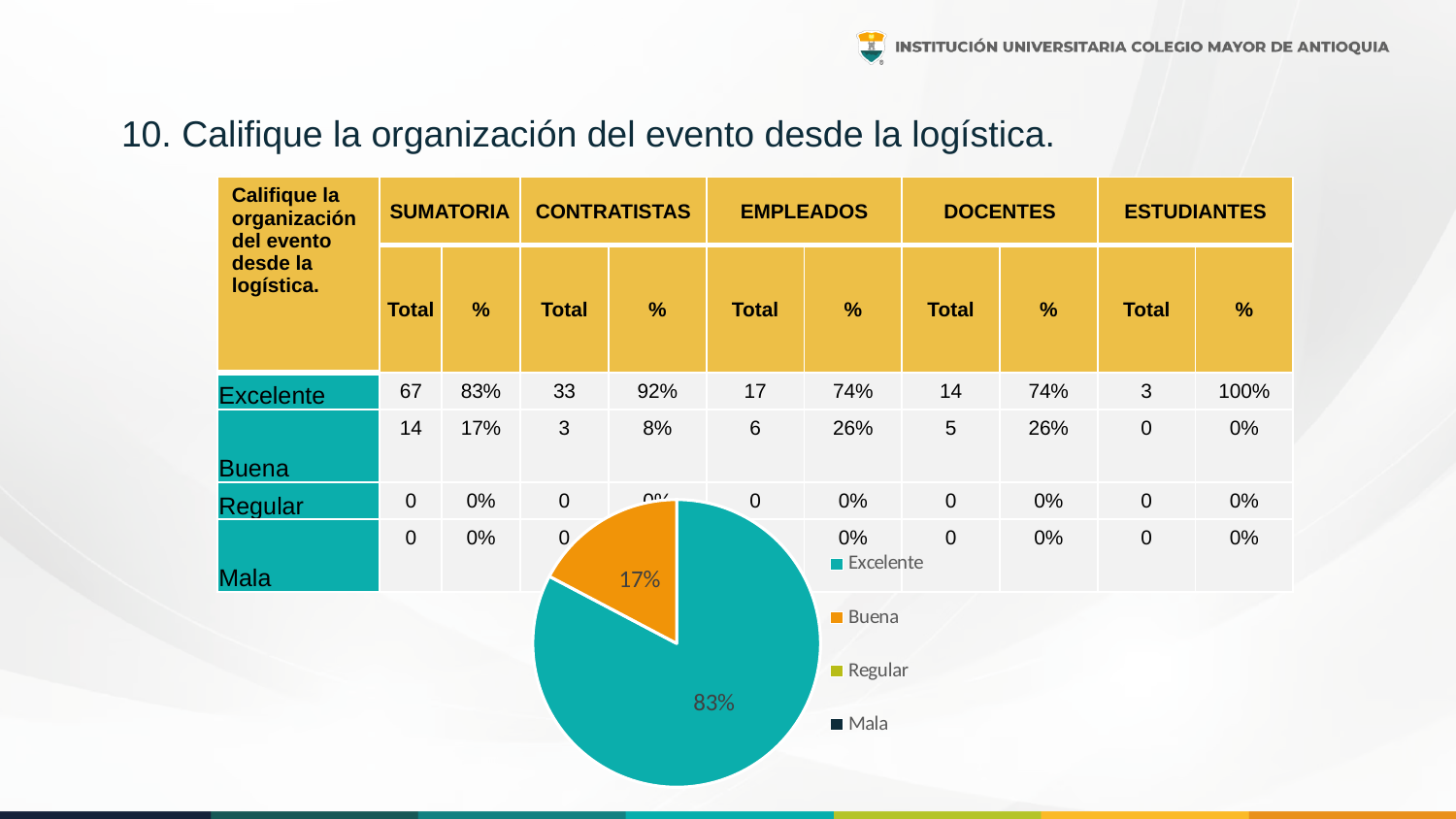
How many slices with printed percentage labels are visible in the pie chart? 2 What colour is the Buena slice in the pie chart? orange Is the Excelente share in the pie chart greater or less than 50%? greater How many categories does the pie chart's legend list? 4 What colour is the Excelente slice in the pie chart? teal What is the difference between the Excelente share and the Buena share in the pie chart? 66% What do the two labelled slices of the pie chart add up to? 100% What share of the pie chart does the Buena slice represent? 17% What share of the pie chart does the Excelente slice represent? 83% Which category has the largest slice in the pie chart? Excelente What kind of chart is shown on the slide? pie chart Which of the two labelled slices is smaller, Excelente or Buena? Buena